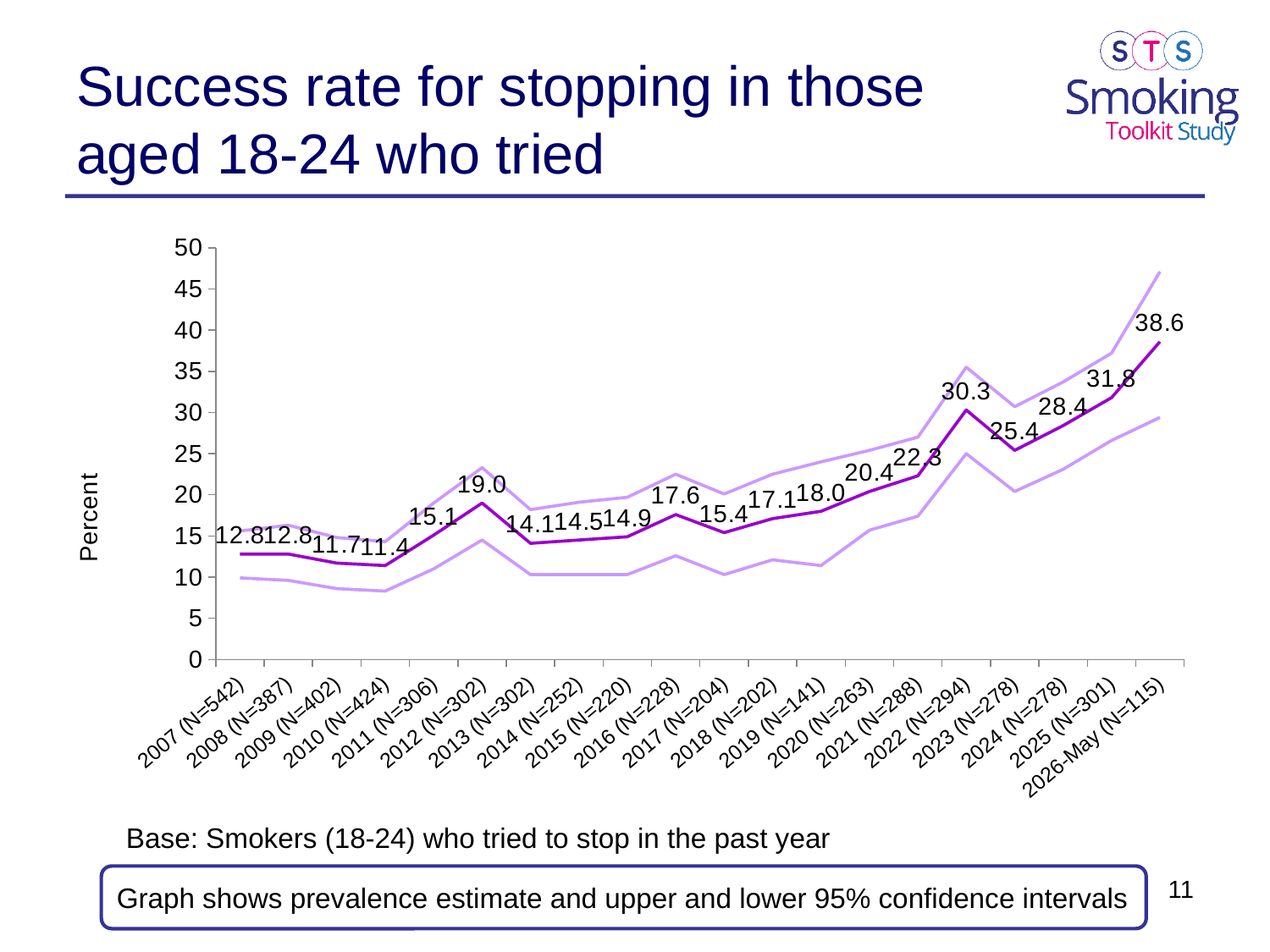
Is the lower confidence interval value for 2022 (N=294) greater or less than 20? greater What is the success rate for 2026-May (N=115)? 38.6 What is the success rate for 2023 (N=278)? 25.4 What is the difference between the success rate in 2022 (N=294) and 2021 (N=288)? 8.0 Which has a higher success rate, 2012 (N=302) or 2016 (N=228)? 2012 (N=302) Which year has the highest success rate? 2026-May (N=115) Does the success rate rise or fall from 2021 (N=288) to 2026-May (N=115)? rise What kind of chart is shown on the slide? line chart What is the success rate for 2012 (N=302)? 19.0 What is the difference between the success rate in 2026-May (N=115) and 2025 (N=301)? 6.8 How many years are plotted on the x axis? 20 Which year has the lowest success rate? 2010 (N=424)